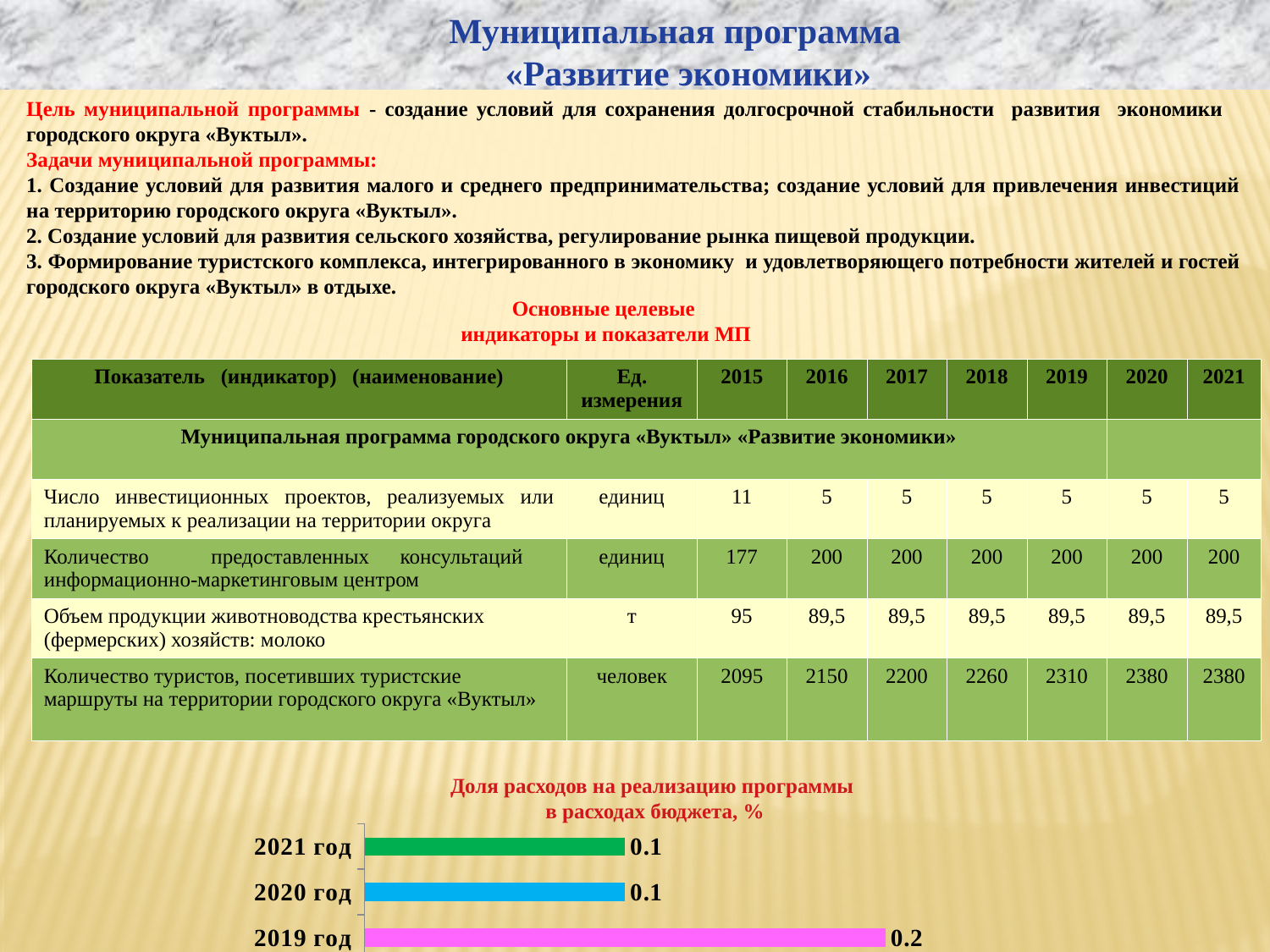
What is the value for 2019 год in the chart 'Доля расходов на реализацию программы в расходах бюджета, %'? 0.2 In the chart 'Доля расходов на реализацию программы в расходах бюджета, %', which is larger: the value for 2019 год or the value for 2021 год? 2019 год How many years (categories) are shown in the chart 'Доля расходов на реализацию программы в расходах бюджета, %'? 3 What colour is the bar for 2019 год in the chart 'Доля расходов на реализацию программы в расходах бюджета, %'? pink (magenta) What is the value for 2021 год in the chart 'Доля расходов на реализацию программы в расходах бюджета, %'? 0.1 What kind of chart is 'Доля расходов на реализацию программы в расходах бюджета, %'? bar chart Are the values for 2020 год and 2021 год equal in the chart 'Доля расходов на реализацию программы в расходах бюджета, %'? Yes, both are 0.1 What is the title of the chart at the bottom of the slide? Доля расходов на реализацию программы в расходах бюджета, % Which year has the highest value in the chart 'Доля расходов на реализацию программы в расходах бюджета, %'? 2019 год What is the value for 2020 год in the chart 'Доля расходов на реализацию программы в расходах бюджета, %'? 0.1 What is the difference between the values for 2019 год and 2020 год in the chart 'Доля расходов на реализацию программы в расходах бюджета, %'? 0.1